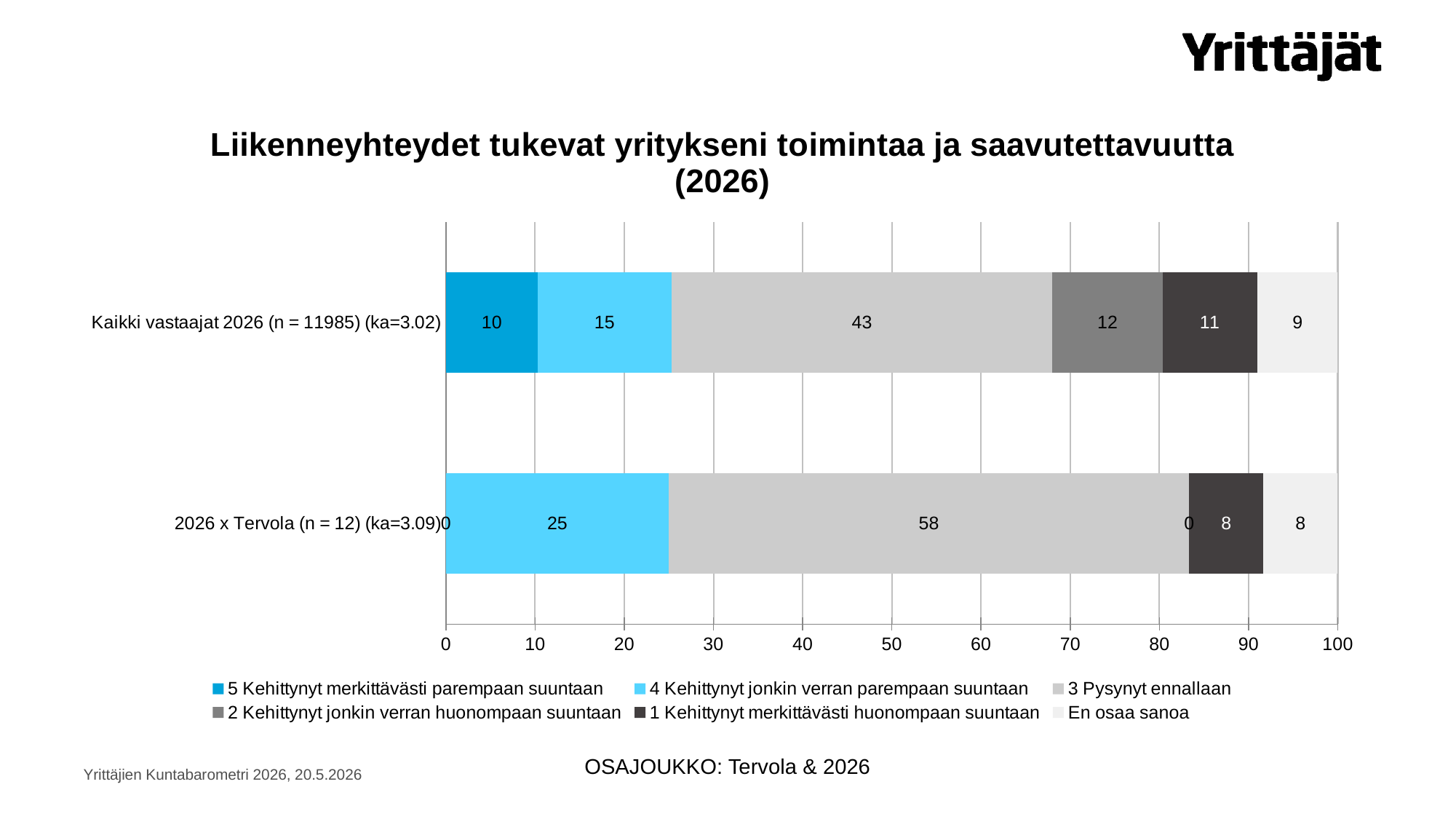
Which category has the larger value for '2 Kehittynyt jonkin verran huonompaan suuntaan': 'Kaikki vastaajat 2026 (n = 11985) (ka=3.02)' or '2026 x Tervola (n = 12) (ka=3.09)'? Kaikki vastaajat 2026 (n = 11985) (ka=3.02) What is the value of '4 Kehittynyt jonkin verran parempaan suuntaan' for '2026 x Tervola (n = 12) (ka=3.09)'? 25 Which series has the highest value in the 'Kaikki vastaajat 2026 (n = 11985) (ka=3.02)' bar? 3 Pysynyt ennallaan How many categories (bars) are shown in the chart? 2 What is the value of '3 Pysynyt ennallaan' for '2026 x Tervola (n = 12) (ka=3.09)'? 58 What is the difference between the '3 Pysynyt ennallaan' values for '2026 x Tervola (n = 12) (ka=3.09)' and 'Kaikki vastaajat 2026 (n = 11985) (ka=3.02)'? 15 What is the value of '5 Kehittynyt merkittävästi parempaan suuntaan' for 'Kaikki vastaajat 2026 (n = 11985) (ka=3.02)'? 10 What is the value of '3 Pysynyt ennallaan' for 'Kaikki vastaajat 2026 (n = 11985) (ka=3.02)'? 43 What type of chart is shown on the slide? Stacked bar chart What is the total of the stacked bar for 'Kaikki vastaajat 2026 (n = 11985) (ka=3.02)'? 100 How many series does the legend list? 6 What is the value of '1 Kehittynyt merkittävästi huonompaan suuntaan' for '2026 x Tervola (n = 12) (ka=3.09)'? 8